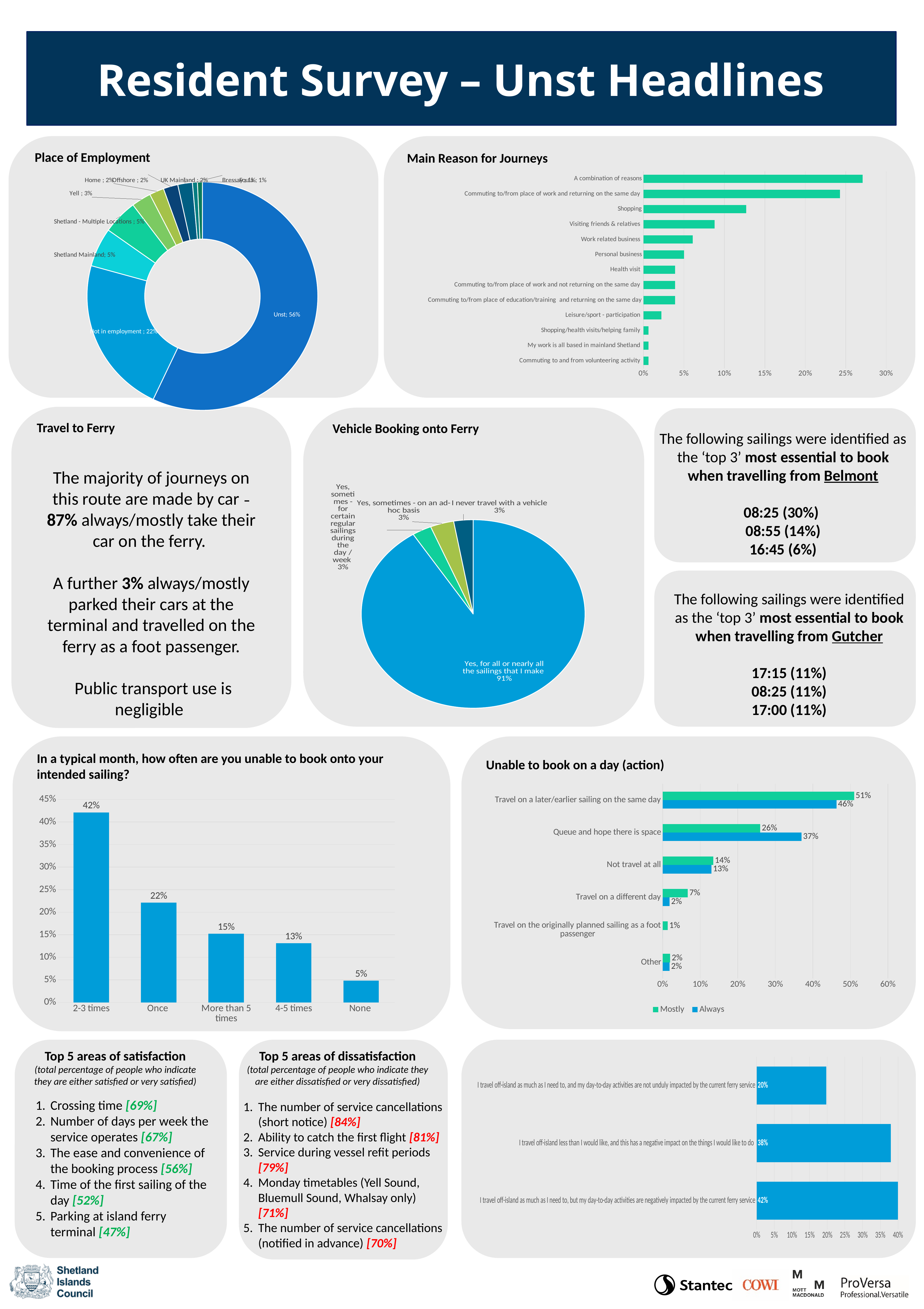
In the Main Reason for Journeys chart, how many reasons are listed? 13 In the Unable to book on a day (action) chart, how many series does the legend list? 2 In the chart 'In a typical month, how often are you unable to book onto your intended sailing?', what is the value for Once? 22% In the Vehicle Booking onto Ferry pie chart, what share of respondents take a vehicle for all or nearly all the sailings they make? 91% In the Place of Employment chart, what percentage of respondents work in Unst? 56% In the chart 'In a typical month, how often are you unable to book onto your intended sailing?', which category has the lowest value? None In the Main Reason for Journeys chart, is the value for Shopping greater or less than 10%? greater In the chart 'In a typical month, how often are you unable to book onto your intended sailing?', what is the difference between the values for 2-3 times and 4-5 times? 29% In the Unable to book on a day (action) chart, what is the Always value for 'Queue and hope there is space'? 37% In the Main Reason for Journeys chart, which reason has the longest bar? A combination of reasons In the Place of Employment chart, what percentage of respondents are not in employment? 22% In the bottom-right bar chart, what is the value for 'I travel off-island less than I would like, and this has a negative impact on the things I would like to do'? 38%